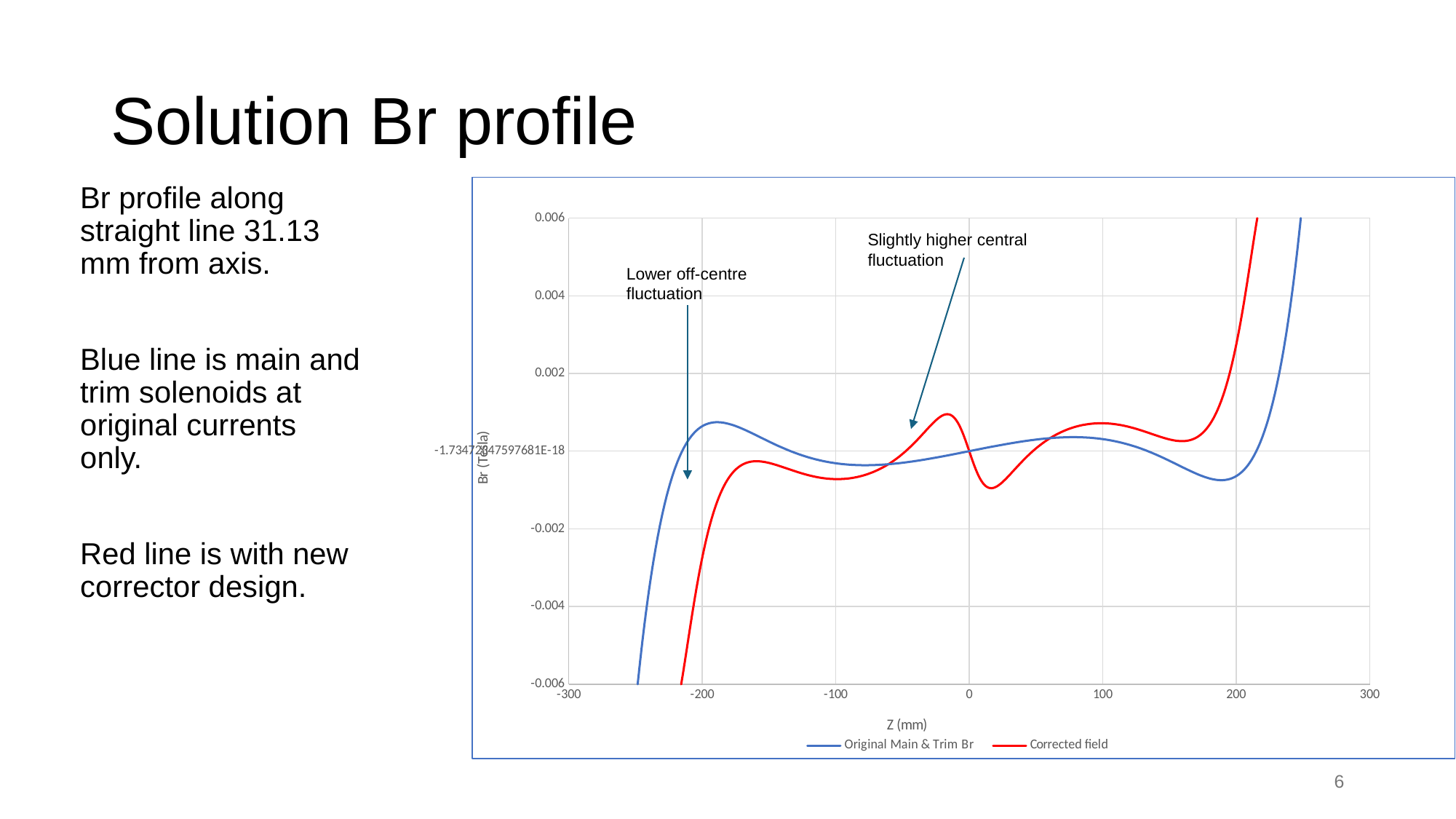
At Z = 200 mm, which series has the higher Br value, 'Original Main & Trim Br' or 'Corrected field'? Corrected field What is the label of the x axis of the chart? Z (mm) What colour is the 'Corrected field' series in the chart? Red Does the 'Original Main & Trim Br' line rise or fall as Z goes from 200 mm to 250 mm? Rise Does the 'Corrected field' line rise or fall as Z goes from -200 mm to -160 mm? Rise Is the 'Original Main & Trim Br' value at Z = -250 mm greater or less than -0.004? less Is the 'Corrected field' value at Z = 200 mm greater or less than 0.002? greater Is the 'Original Main & Trim Br' value at Z = 0 mm greater or less than 0.002? less How many series does the chart legend list? 2 At Z = -200 mm, which series has the higher Br value, 'Original Main & Trim Br' or 'Corrected field'? Original Main & Trim Br What kind of chart is shown on the slide? Line chart